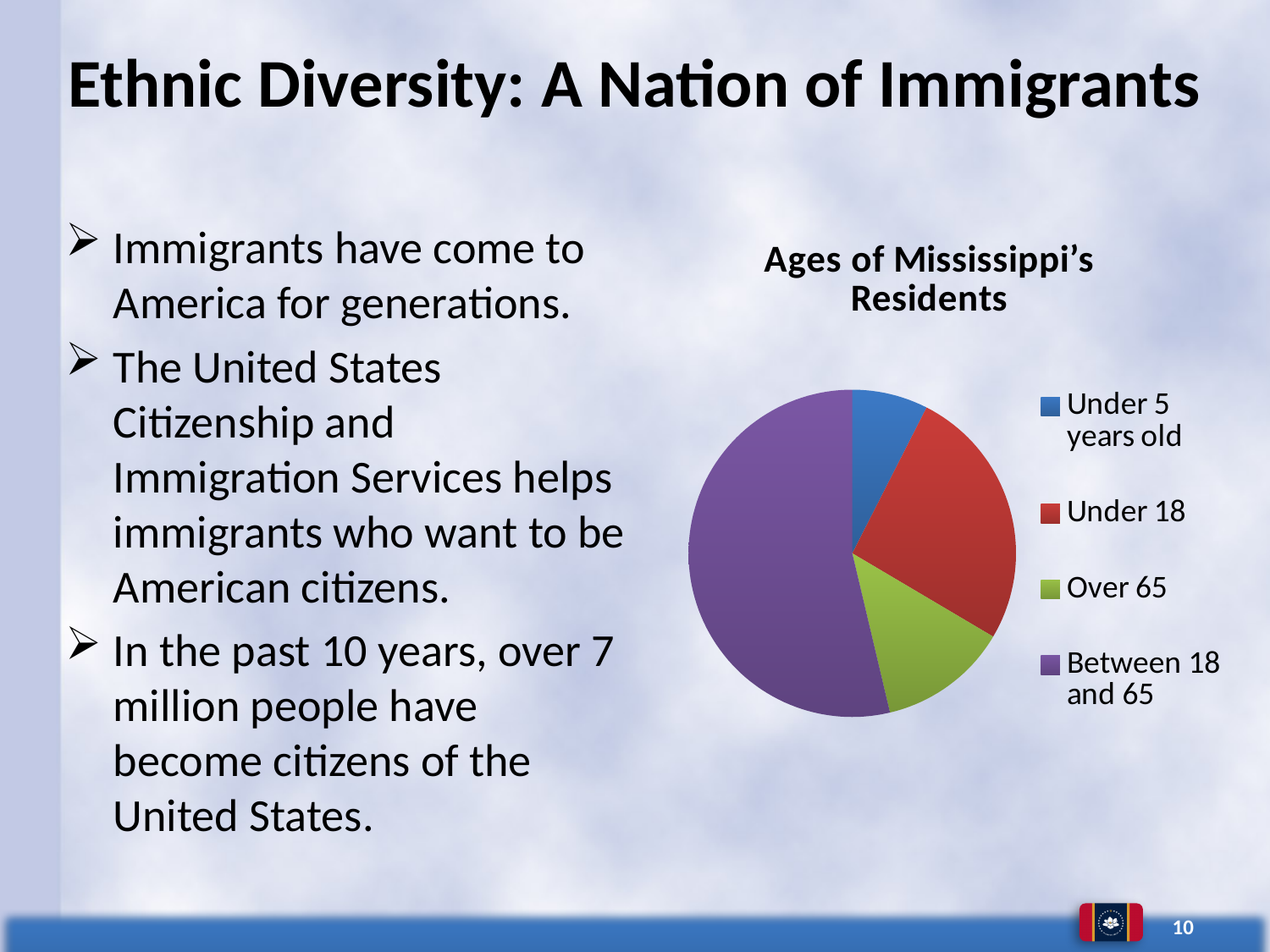
Which slice is larger, Under 18 or Over 65? Under 18 What colour is the slice for Between 18 and 65 in the pie chart? Purple How many age categories does the pie chart show? 4 Which age category has the smallest slice of the pie chart? Under 5 years old Which slice is larger, Between 18 and 65 or Under 18? Between 18 and 65 Which age category has the largest slice of the pie chart? Between 18 and 65 Which slice is larger, Under 5 years old or Over 65? Over 65 What kind of chart is shown on the slide? Pie chart What is the title of the chart on the slide? Ages of Mississippi's Residents